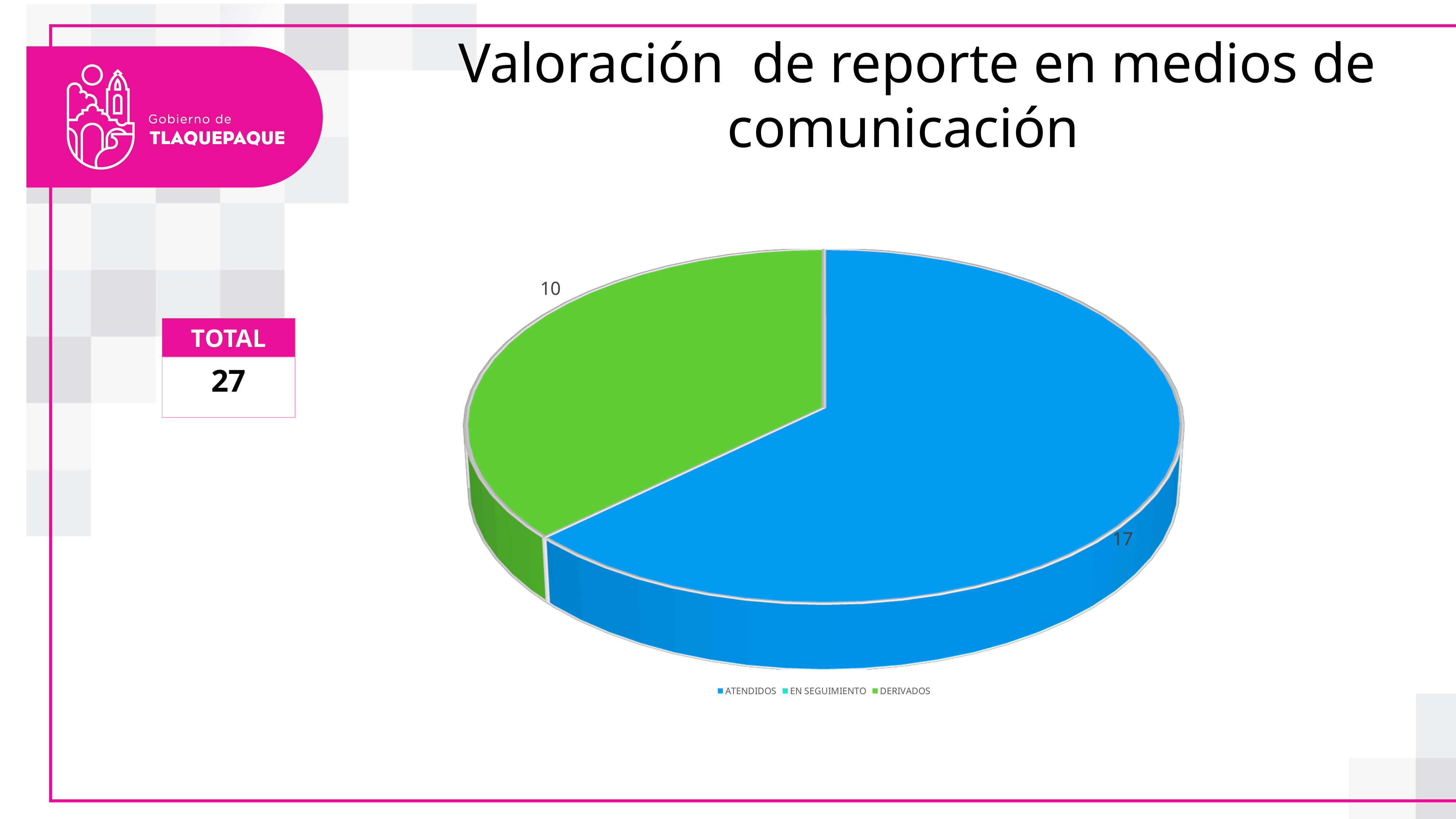
Which category has the largest slice in the pie chart? ATENDIDOS What is the value of the DERIVADOS slice in the pie chart? 10 What colour is the DERIVADOS slice in the pie chart? green What is the total shown in the TOTAL box on the slide? 27 What kind of chart is shown on the slide? pie chart How many entries does the chart legend list? 3 What is the title of the chart on the slide? Valoración de reporte en medios de comunicación What is the value of the ATENDIDOS slice in the pie chart? 17 What is the difference between the ATENDIDOS value and the DERIVADOS value? 7 Is the ATENDIDOS slice larger or smaller than the DERIVADOS slice? larger Which of the two labelled slices, ATENDIDOS or DERIVADOS, is smaller? DERIVADOS